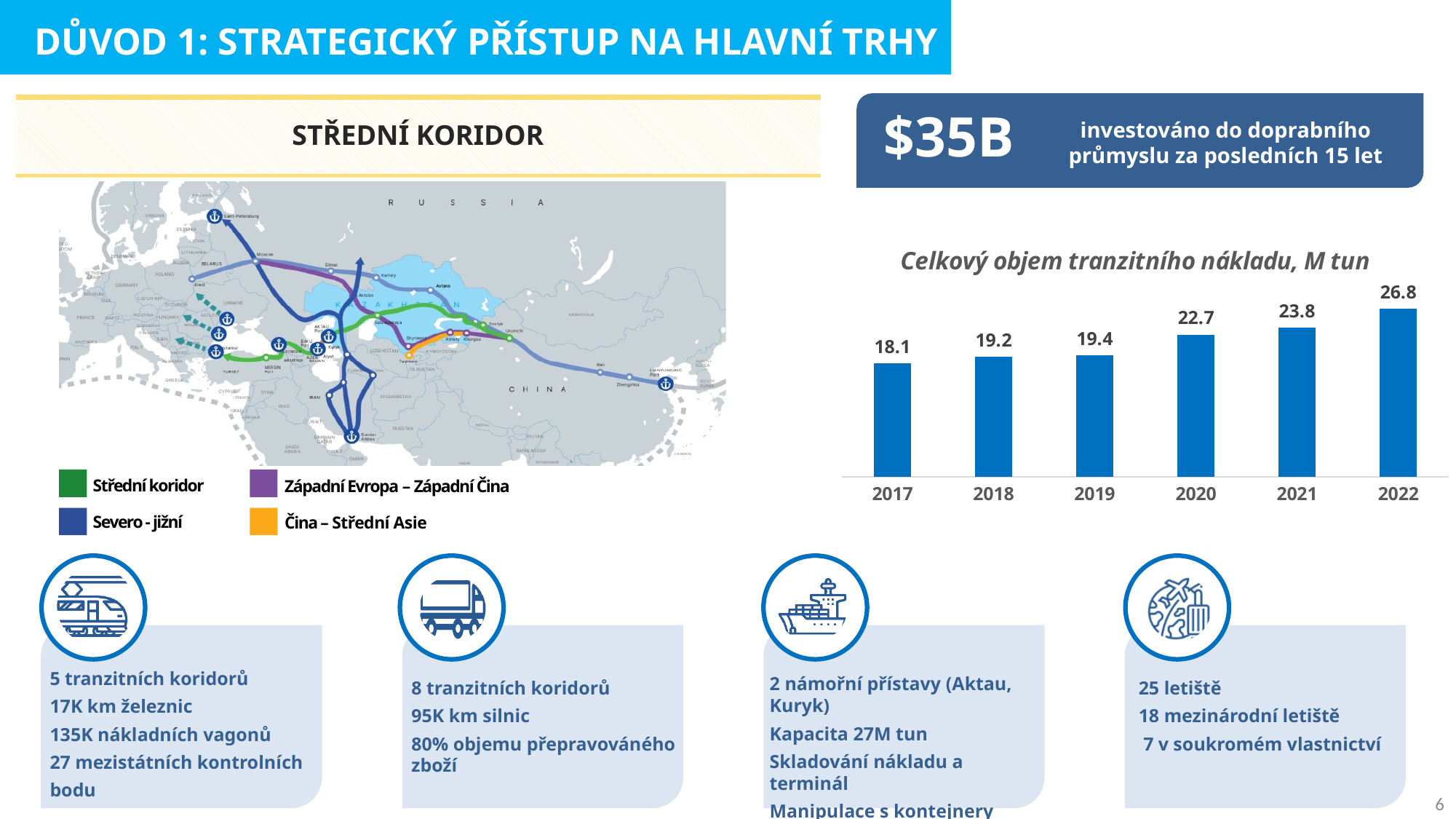
What is the total transit cargo volume shown for 2022? 26.8 How many years are shown on the transit cargo volume chart? 6 What type of chart is used to show the total transit cargo volume? Bar chart What is the title of the chart on the right side of the slide? Celkový objem tranzitního nákladu, M tun What is the total transit cargo volume shown for 2020? 22.7 What is the difference in transit cargo volume between 2022 and 2017? 8.7 What is the difference in transit cargo volume between 2021 and 2020? 1.1 Which year has a larger transit cargo volume, 2019 or 2021? 2021 What is the total transit cargo volume shown for 2017? 18.1 Which year has the lowest total transit cargo volume? 2017 Does the total transit cargo volume rise or fall from 2017 to 2022? Rise Which year has the highest total transit cargo volume? 2022